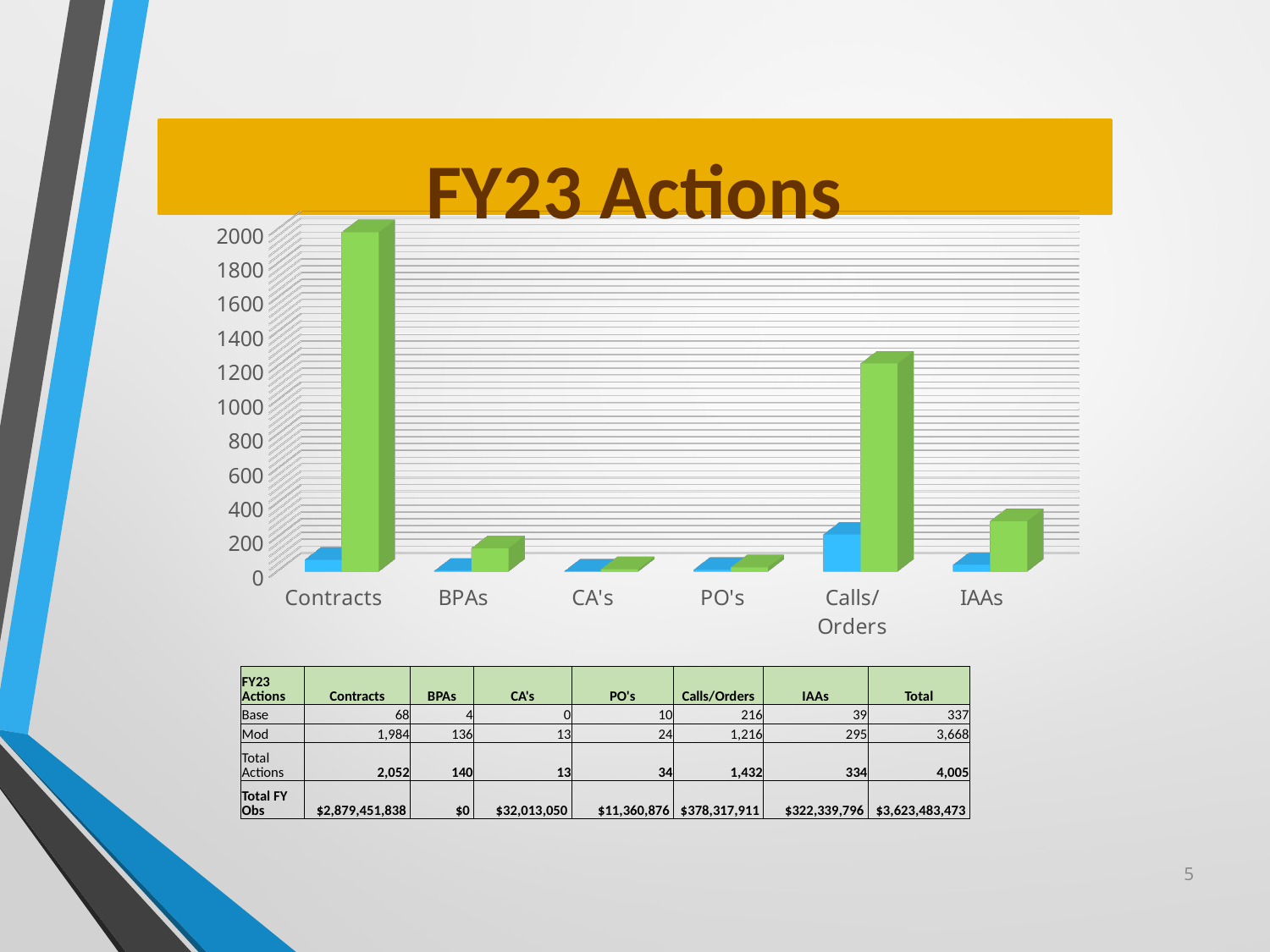
Is the green bar for Calls/Orders greater or less than 1000? greater Using the table below the chart, what is the difference between the Mod values for Contracts and Calls/Orders? 768 According to the table below the chart, what is the Mod value for Contracts? 1,984 Is the green bar for Contracts greater or less than 1800? greater According to the table below the chart, what is the Base value for Calls/Orders? 216 Is the blue bar for Contracts greater or less than 200? less How many categories are shown along the x axis of the chart? 6 What is the title of the chart? FY23 Actions Which category has the tallest green bar in the chart? Contracts According to the table below the chart, what is the Total Actions value for IAAs? 334 What kind of chart is shown on the slide? bar chart Which is larger, the green bar for BPAs or the green bar for IAAs? IAAs